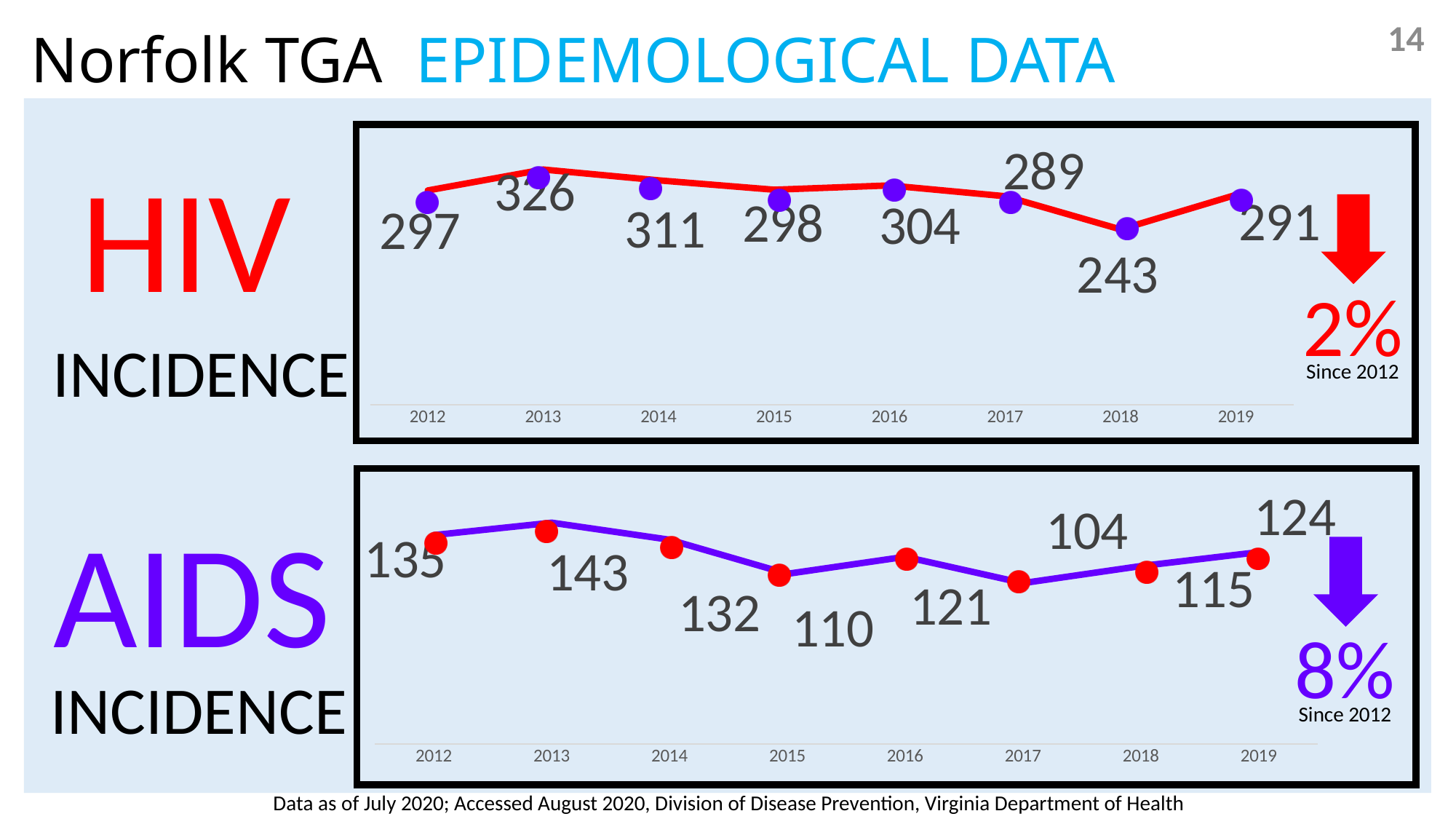
What kind of chart is the HIV Incidence chart? Line chart In the AIDS Incidence chart, what is the difference between the 2012 value and the 2019 value? 11 In the AIDS Incidence chart, is the value for 2012 or 2019 larger? 2012 In the AIDS Incidence chart, which year has the highest value? 2013 In the HIV Incidence chart, what is the difference between the 2013 value and the 2018 value? 83 What percentage decrease since 2012 is shown next to the AIDS Incidence chart? 8% In the AIDS Incidence chart, which year has the lowest value? 2017 In the HIV Incidence chart, which year has the highest value? 2013 In the AIDS Incidence chart, what is the value for 2017? 104 In the HIV Incidence chart, which year has the lowest value? 2018 In the HIV Incidence chart, how many years are plotted? 8 In the HIV Incidence chart, what is the value for 2013? 326